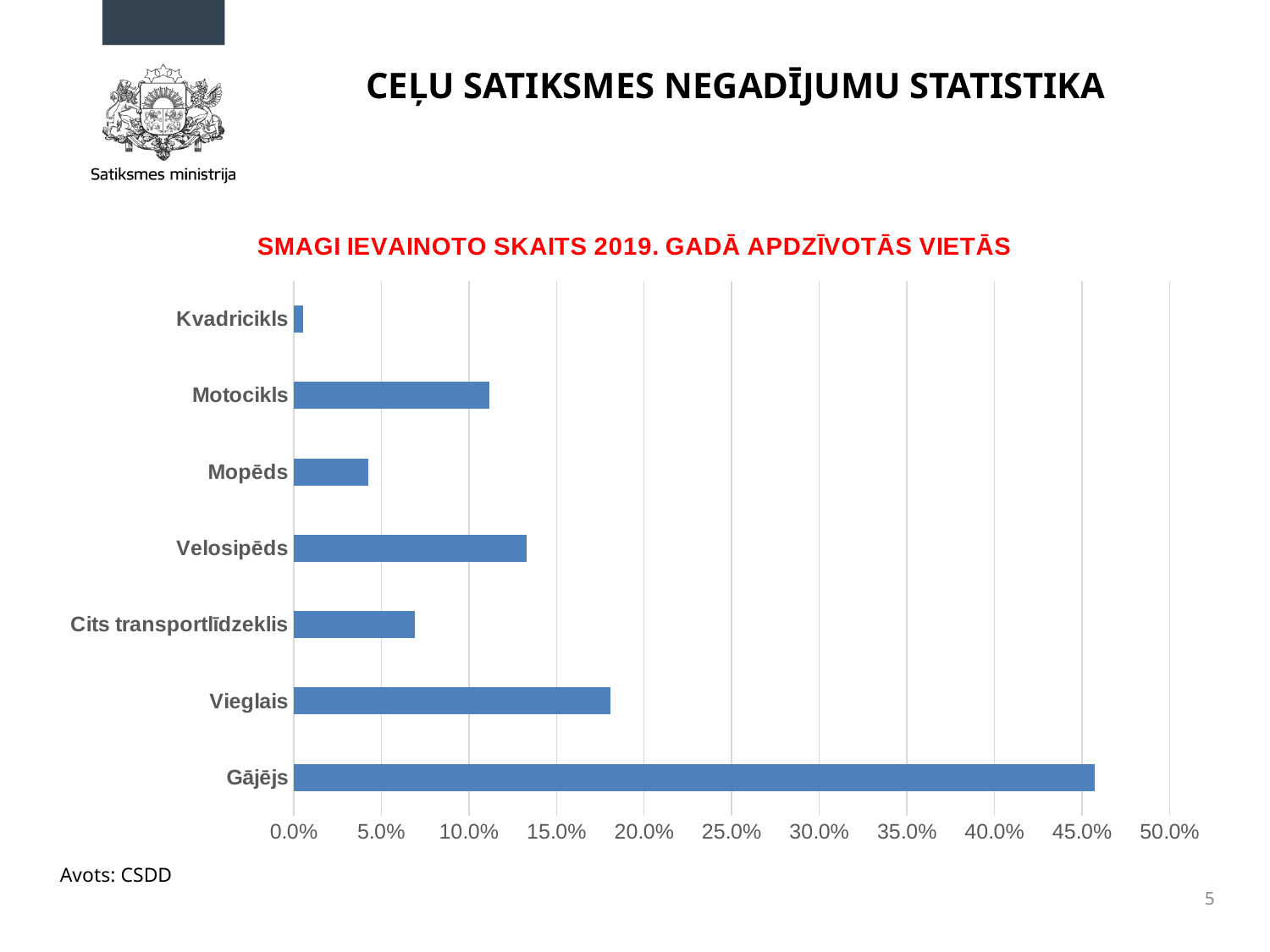
Is the value for Mopēds greater or less than 5.0%? less Is the value for Cits transportlīdzeklis greater or less than 5.0%? greater Which has a larger value, Vieglais or Velosipēds? Vieglais Which has a larger value, Motocikls or Mopēds? Motocikls Which category has the highest value in the chart? Gājējs How many categories are shown in the chart? 7 Is the value for Vieglais greater or less than 20.0%? less Which category has the lowest value in the chart? Kvadricikls What is the title of the chart? SMAGI IEVAINOTO SKAITS 2019. GADĀ APDZĪVOTĀS VIETĀS What kind of chart is shown on the slide? bar chart